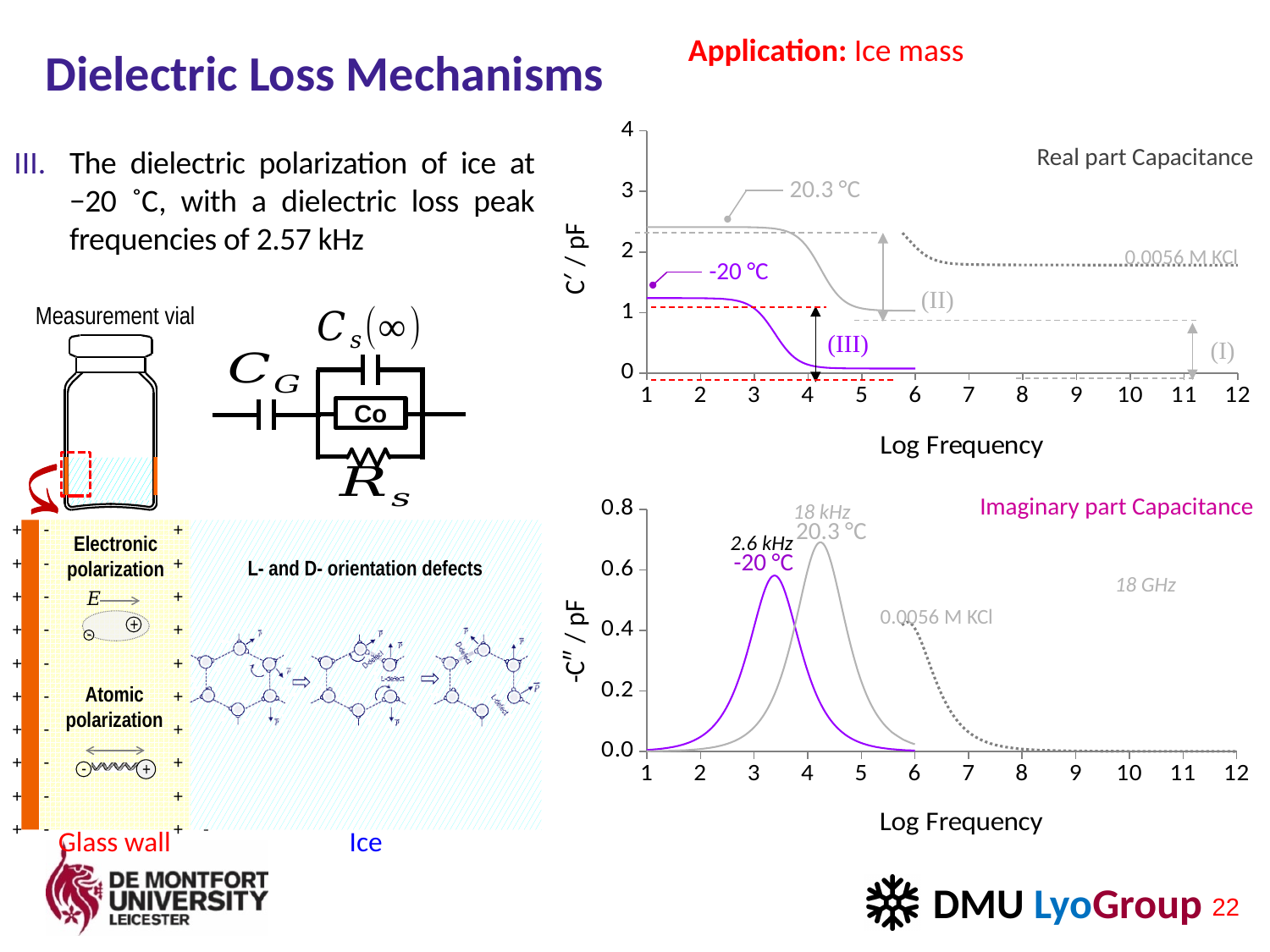
In the Real part Capacitance chart, which curve is higher at log frequency 2, 20.3 °C or -20 °C? 20.3 °C How many curves are plotted in the Imaginary part Capacitance chart? 3 In the Real part Capacitance chart, is the value of the 20.3 °C curve at log frequency 2 greater or less than 2? greater What kind of chart is the Real part Capacitance chart? line chart In the Imaginary part Capacitance chart, which curve has the higher peak, 20.3 °C or -20 °C? 20.3 °C In the Imaginary part Capacitance chart, what peak frequency is annotated on the -20 °C curve? 2.6 kHz What is the x-axis label of the Real part Capacitance chart? Log Frequency In the Imaginary part Capacitance chart, is the peak value of the 20.3 °C curve greater or less than 0.6? greater In the Real part Capacitance chart, does the 20.3 °C curve rise or fall as log frequency increases? fall In the Imaginary part Capacitance chart, is the peak value of the -20 °C curve greater or less than 0.4? greater